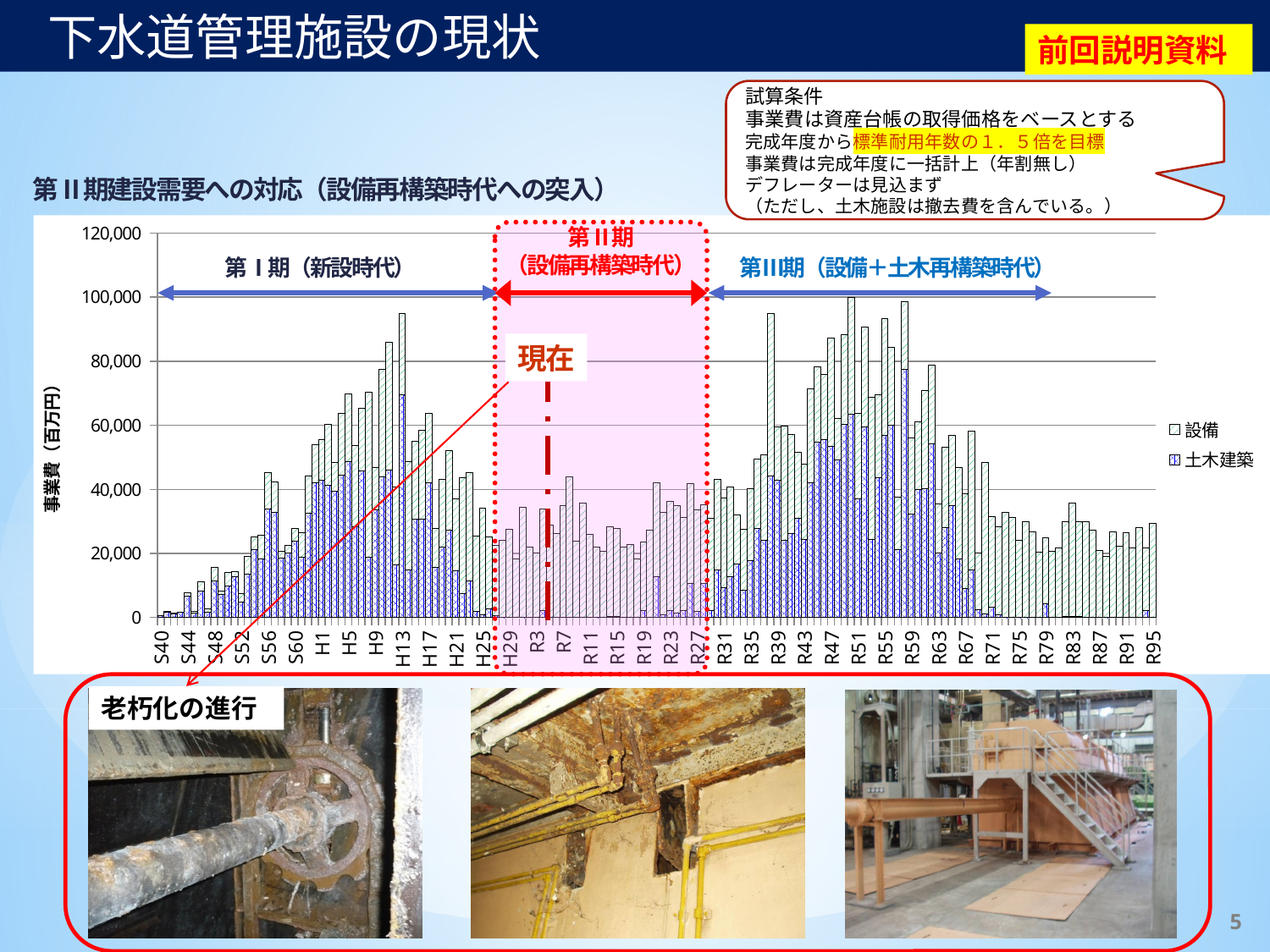
Is the total value of the bar for R51 greater or less than 80,000? less What is the label of the vertical axis of the chart? 事業費（百万円） What kind of chart is shown on the slide? Stacked bar chart Which bar is taller, the one for H13 or the one for R15? H13 How many series does the chart legend list? 2 What is the highest value shown on the vertical axis of the chart? 120,000 Is the total value of the bar for R95 greater or less than 40,000? less What is the first category label on the horizontal axis of the chart? S40 Is the total value of the bar for H13 greater or less than 80,000? greater What are the two series named in the chart legend? 設備 and 土木建築